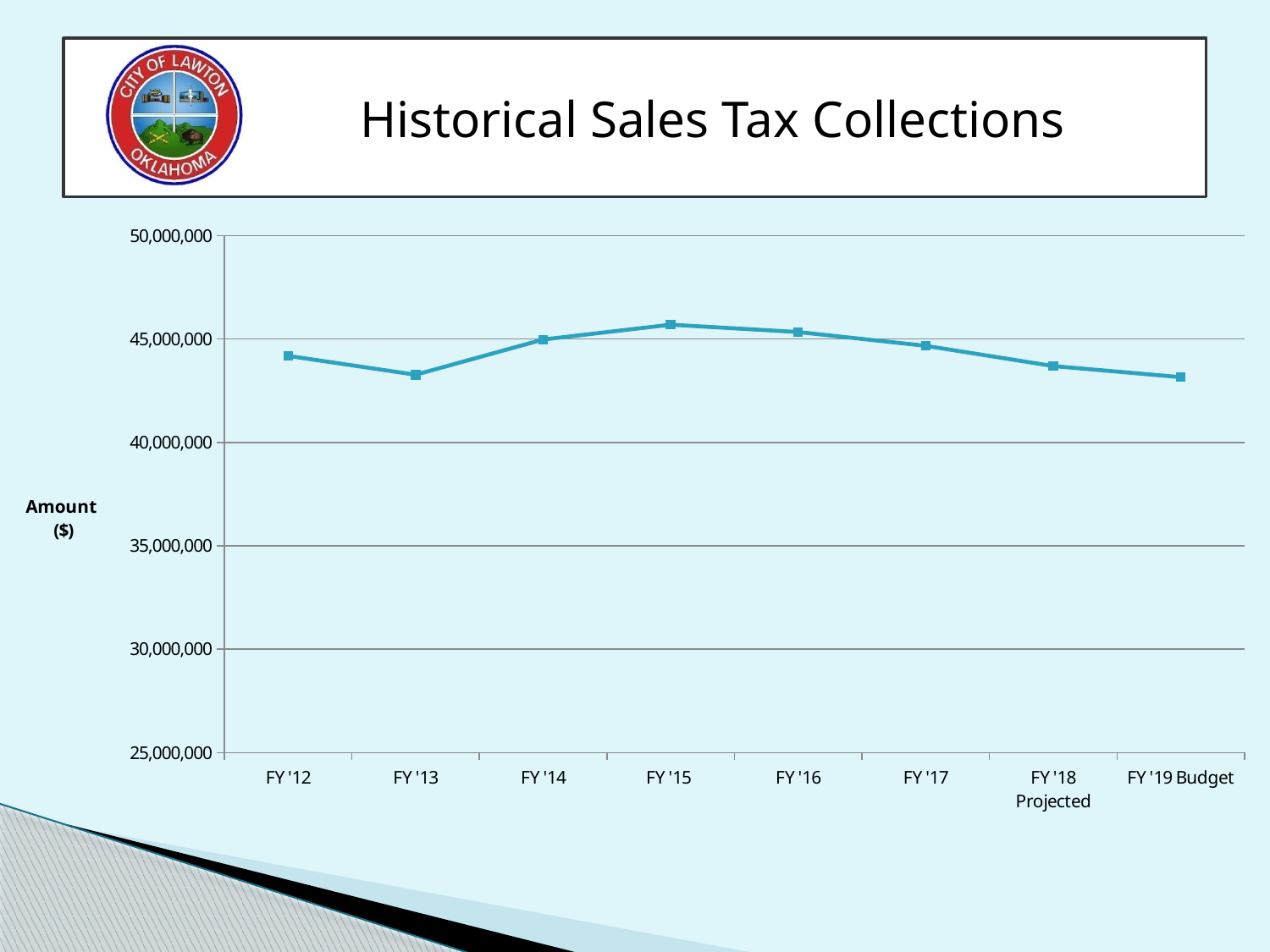
Is the value for FY '15 greater or less than 45,000,000? greater Which is larger, the value for FY '15 or the value for FY '13? FY '15 Is the value for FY '12 greater or less than 45,000,000? less Is the value for FY '13 greater or less than 45,000,000? less What is the title of the chart? Historical Sales Tax Collections Which fiscal year has the highest sales tax collections? FY '15 How many fiscal years are plotted on the x axis? 8 Which is larger, the value for FY '12 or the value for FY '13? FY '12 Do the values rise or fall from FY '15 to FY '19 Budget? fall What kind of chart is shown on the slide? line chart